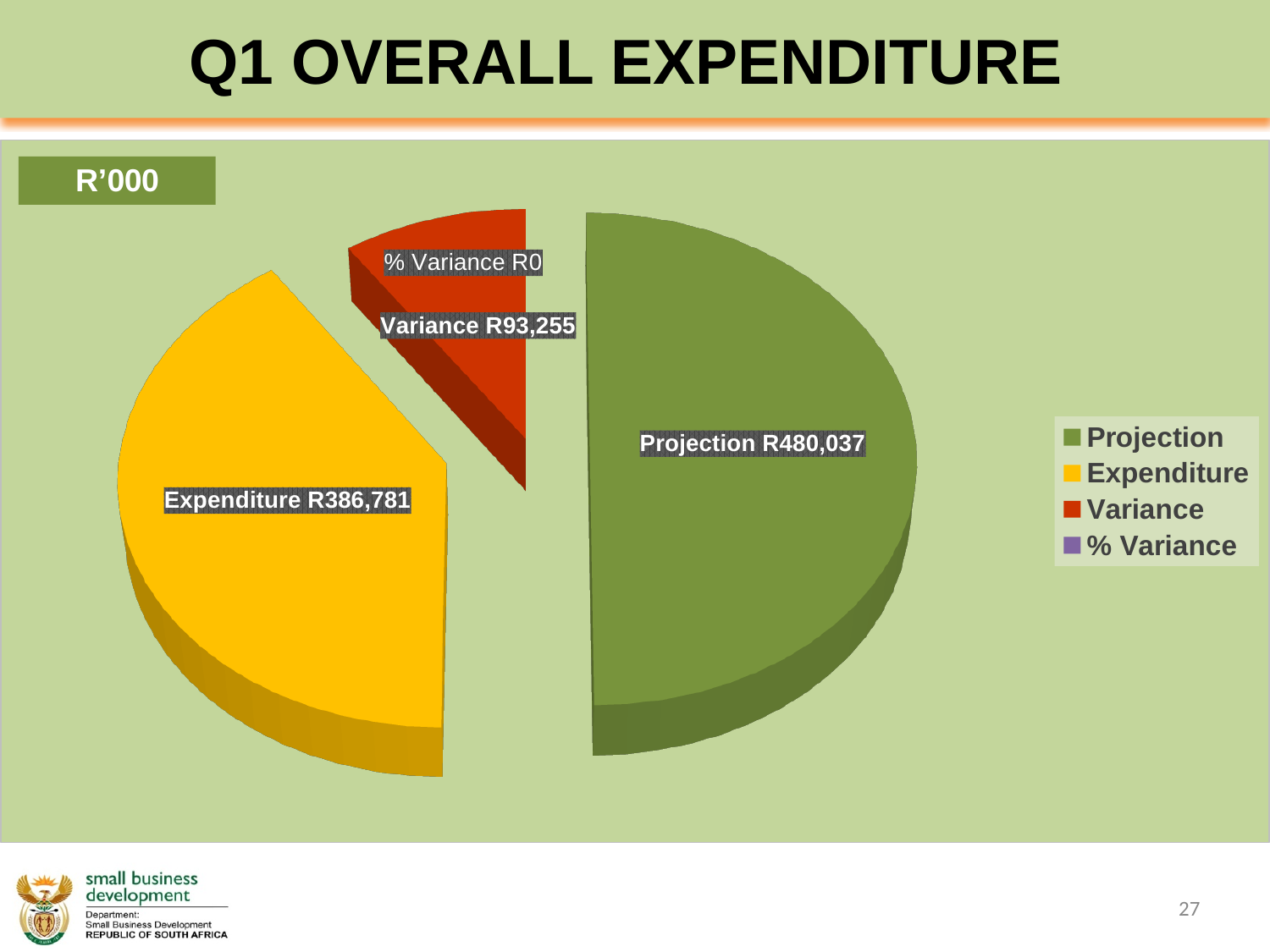
What is the value shown for Variance? R93,255 Which category has the smallest value in the pie chart? % Variance What kind of chart is shown on the slide? Pie chart What is the value shown for Expenditure? R386,781 What is the difference between the Expenditure value and the Variance value? R293,526 What is the value shown for Projection? R480,037 What unit is indicated in the box at the top left of the chart? R'000 Which is larger, Expenditure or Variance? Expenditure What is the value shown for % Variance? R0 What is the title of the slide containing the pie chart? Q1 OVERALL EXPENDITURE Which category has the largest value in the pie chart? Projection How many entries does the legend list? 4